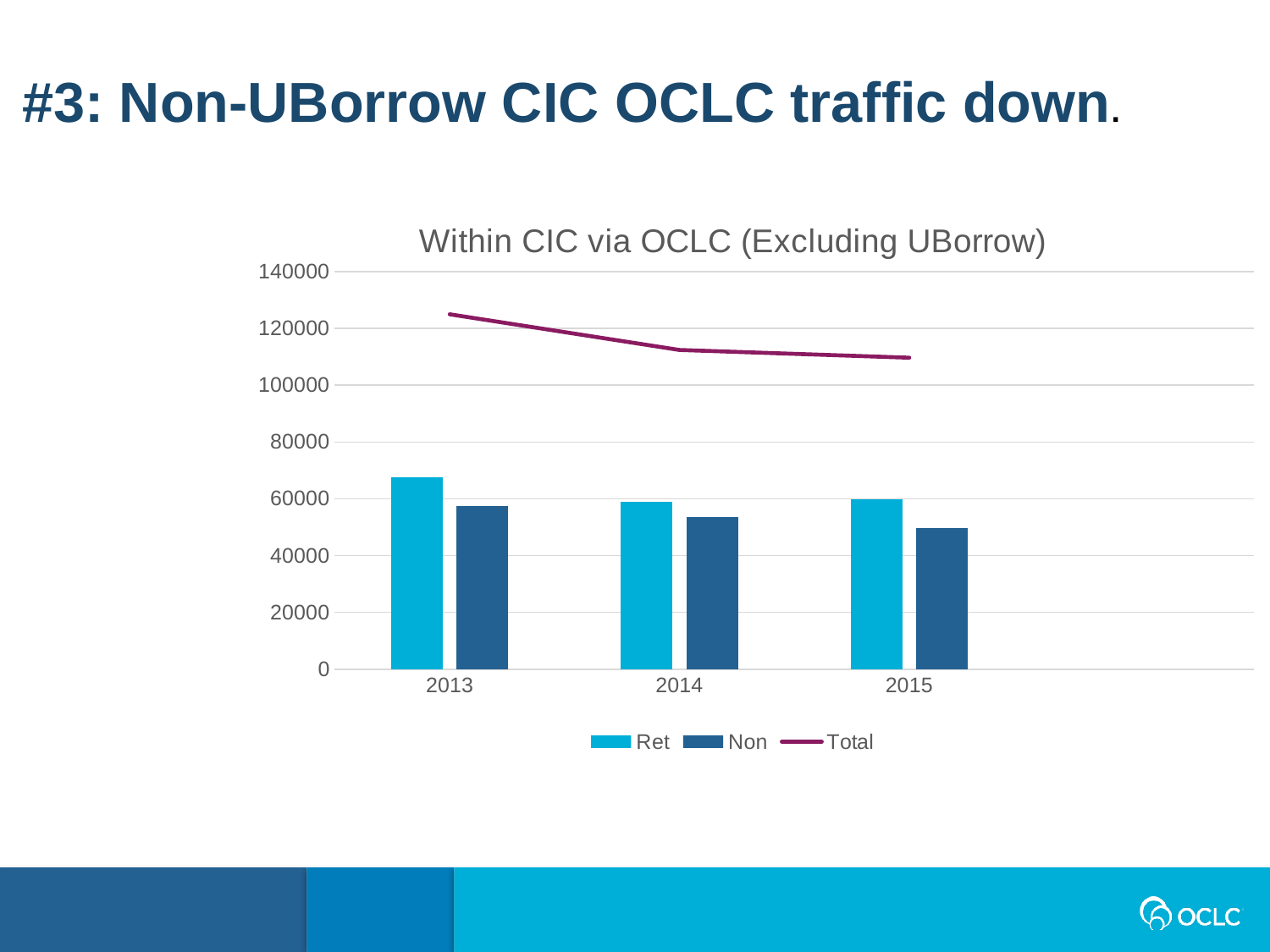
Do the Non bars rise or fall from 2013 to 2015? Fall Is the Total value for 2015 greater or less than 120000? less How many years are shown on the x axis? 3 In which year is the Non value lowest? 2015 How many series does the legend list? 3 What is the title of the chart? Within CIC via OCLC (Excluding UBorrow) In 2013, which is larger, Ret or Non? Ret What kind of chart is this? Combined bar and line chart Is the Non value for 2015 greater or less than 60000? less Is the Total value for 2013 greater or less than 120000? greater Does the Total line rise or fall from 2013 to 2015? Fall